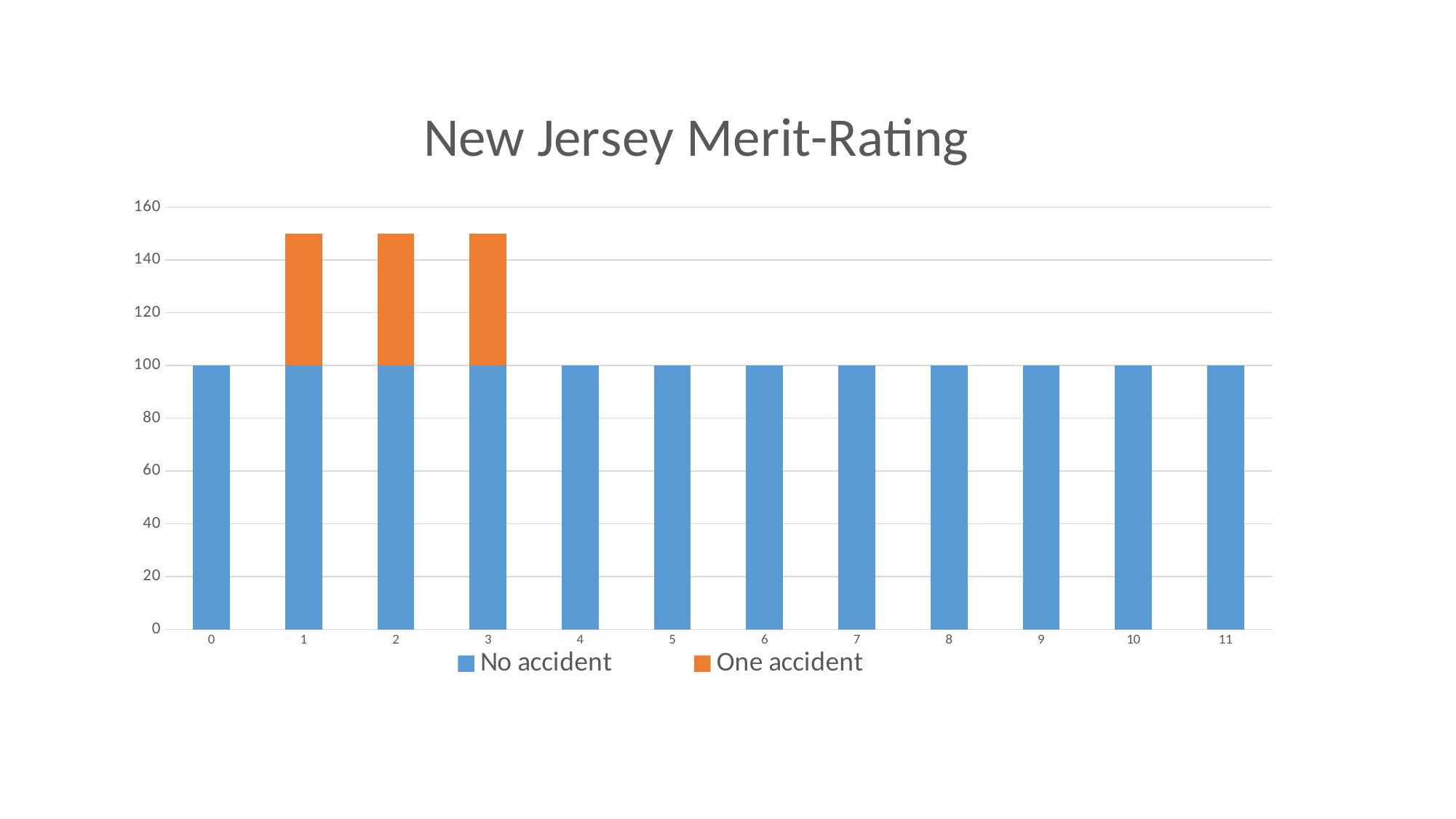
What kind of chart is shown on the slide? Bar chart Is the total height of the bar for category 3 greater or less than 160? less Does the 'No accident' series rise, fall or stay flat across the x axis? Stays flat How many series does the legend list? 2 What is the 'No accident' value for category 7? 100 How many categories include an 'One accident' segment? 3 What is the title of the chart? New Jersey Merit-Rating What is the 'No accident' value for category 0? 100 Is the total height of the bar for category 2 greater or less than 140? greater Which bar is taller in total, category 1 or category 4? Category 1 How many categories are shown along the x axis? 12 Which categories have the tallest total bars? 1, 2 and 3